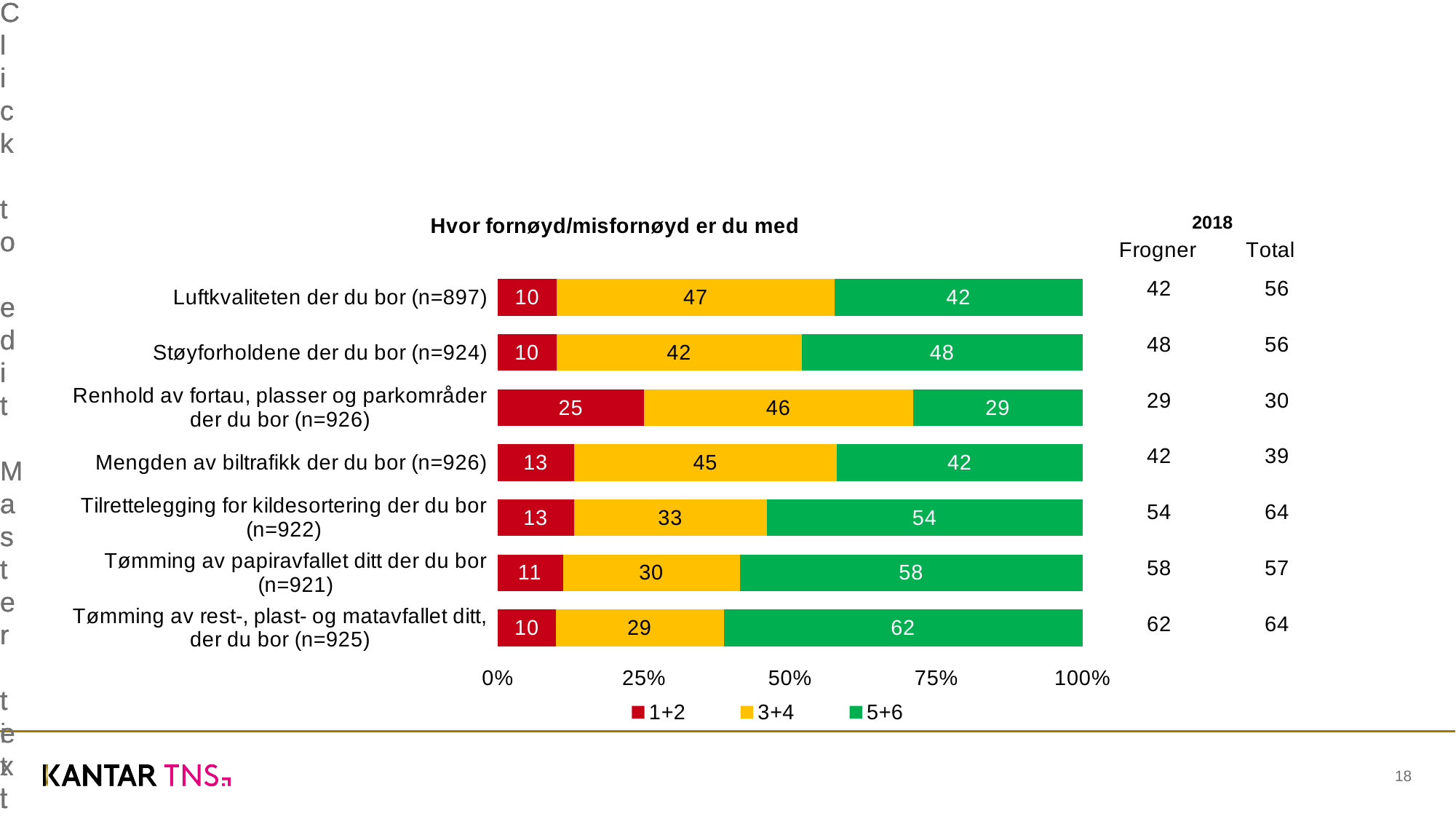
How many series does the legend list? 3 What is the total of the stacked bar for "Mengden av biltrafikk der du bor (n=926)"? 100 Which category has the highest value in the 5+6 series? Tømming av rest-, plast- og matavfallet ditt, der du bor (n=925) What is the value of the 3+4 series for "Luftkvaliteten der du bor (n=897)"? 47 Which is larger: the 3+4 value for "Støyforholdene der du bor (n=924)" or the 3+4 value for "Tømming av papiravfallet ditt der du bor (n=921)"? Støyforholdene der du bor (n=924) What kind of chart is shown on the slide? Stacked bar chart How many categories are shown in the chart? 7 What is the value of the 5+6 series for "Tømming av rest-, plast- og matavfallet ditt, der du bor (n=925)"? 62 What is the value of the 1+2 series for "Renhold av fortau, plasser og parkområder der du bor (n=926)"? 25 What is the title of the chart? Hvor fornøyd/misfornøyd er du med Which category has the lowest value in the 5+6 series? Renhold av fortau, plasser og parkområder der du bor (n=926) What is the difference between the 5+6 values for "Tilrettelegging for kildesortering der du bor (n=922)" and "Mengden av biltrafikk der du bor (n=926)"? 12